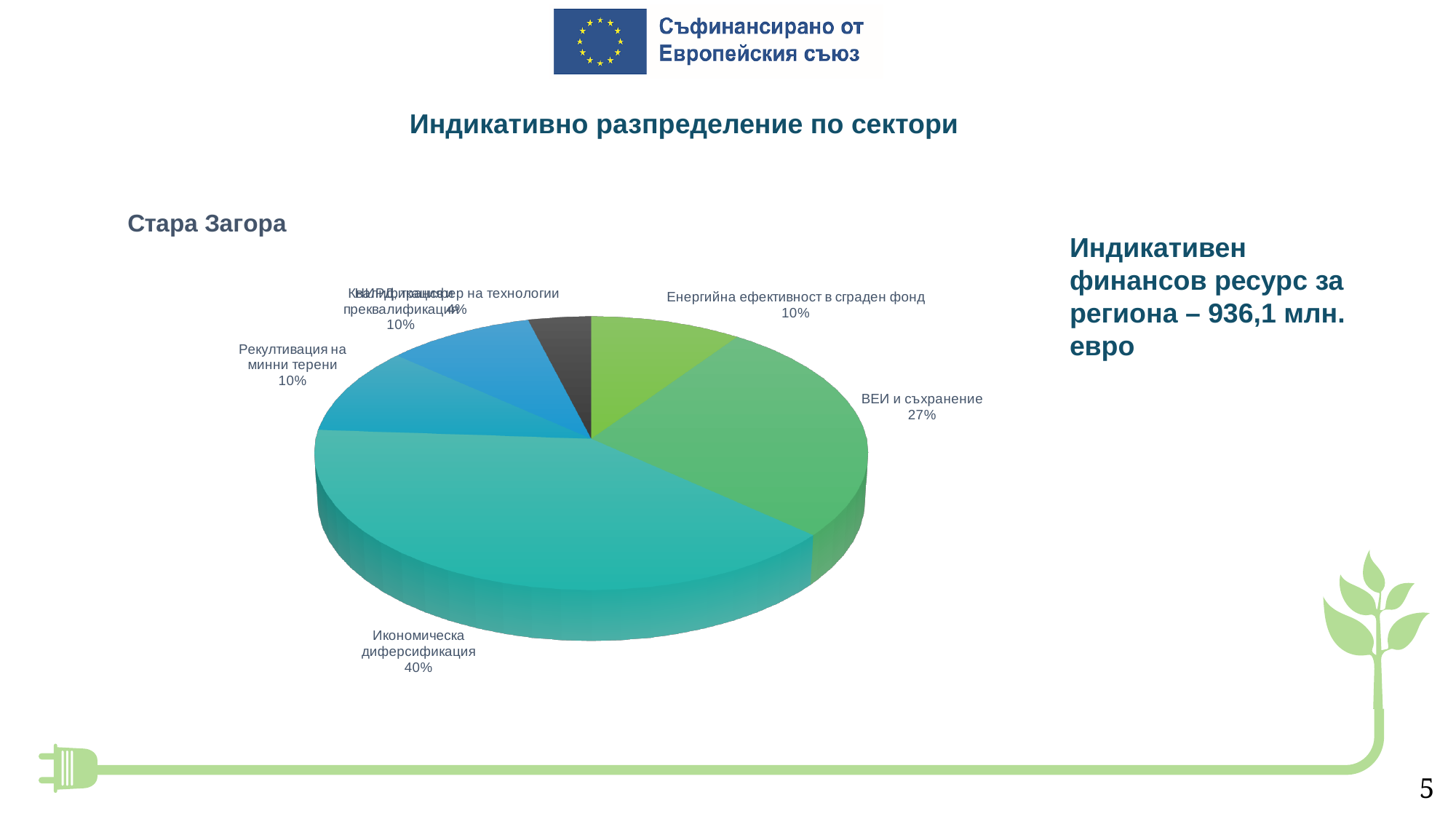
What kind of chart is shown on the slide? pie chart Which is larger, the share for ВЕИ и съхранение or the share for Рекултивация на минни терени? ВЕИ и съхранение What is the title of the slide above the chart? Индикативно разпределение по сектори Which sector has the largest slice of the pie? Икономическа диверсификация How many slices does the pie chart have? 6 What share of the pie does Икономическа диверсификация have? 40% What is the value for Енергийна ефективност в сграден фонд? 10% Which sector has the smallest slice of the pie? НИРД, трансфер на технологии What is the difference between the shares of Икономическа диверсификация and ВЕИ и съхранение? 13% What is the value for Рекултивация на минни терени? 10% What share of the pie does ВЕИ и съхранение have? 27% Which region is the pie chart labelled with? Стара Загора